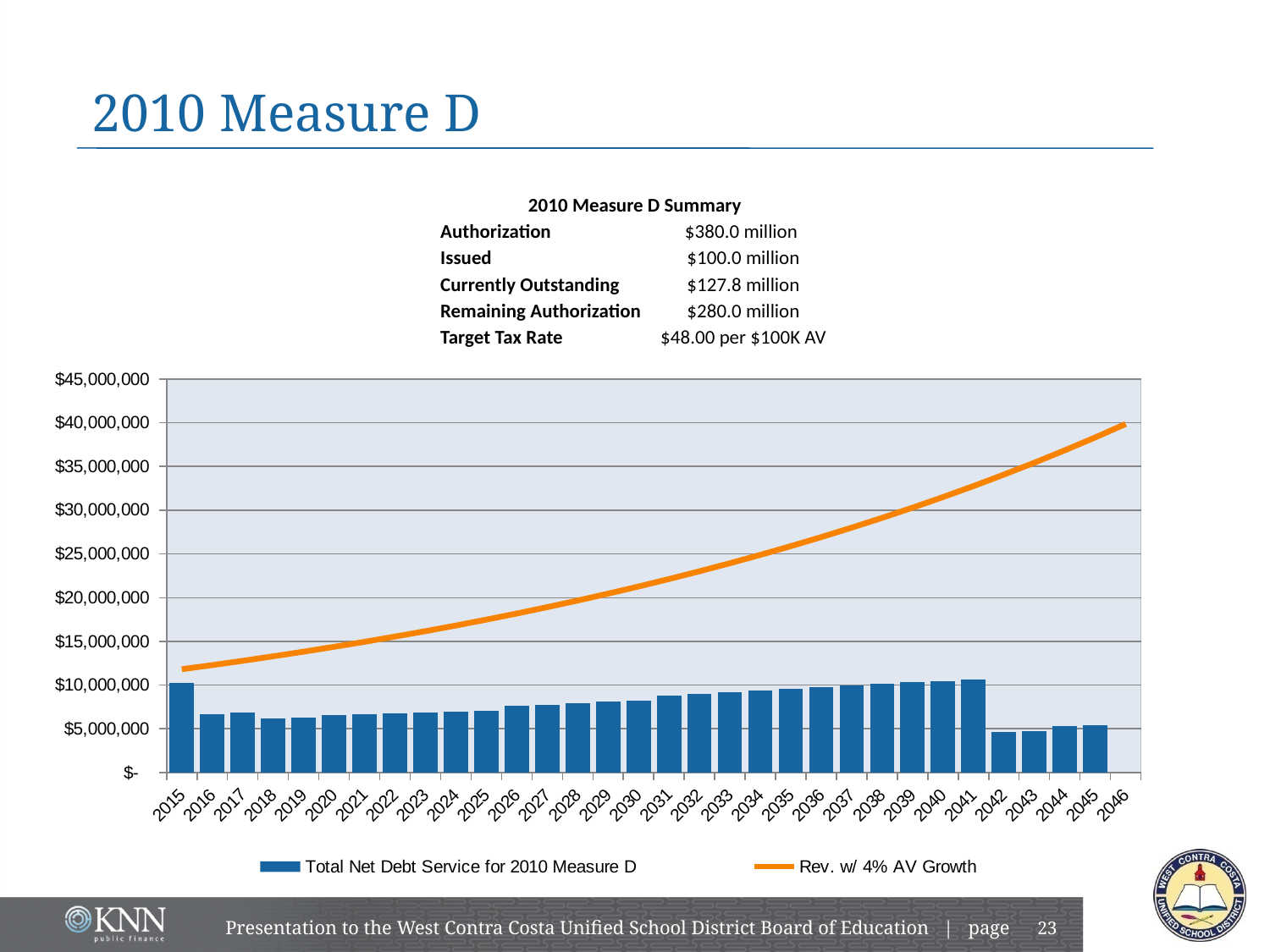
Which year has the highest Total Net Debt Service for 2010 Measure D bar? 2041 Is the Rev. w/ 4% AV Growth value for 2046 greater or less than $35,000,000? greater Does the Rev. w/ 4% AV Growth line rise or fall from 2015 to 2046? Rise How many years are labelled on the x axis of the chart? 32 How many series does the chart legend list? 2 What are the two series named in the chart legend? Total Net Debt Service for 2010 Measure D; Rev. w/ 4% AV Growth Is the Total Net Debt Service bar for 2016 greater or less than $5,000,000? greater Which is larger, the Total Net Debt Service bar for 2041 or for 2042? 2041 Is the Total Net Debt Service bar for 2041 greater or less than $10,000,000? greater What kind of chart is shown on the slide? Combined bar and line chart What colour is the Rev. w/ 4% AV Growth line? Orange